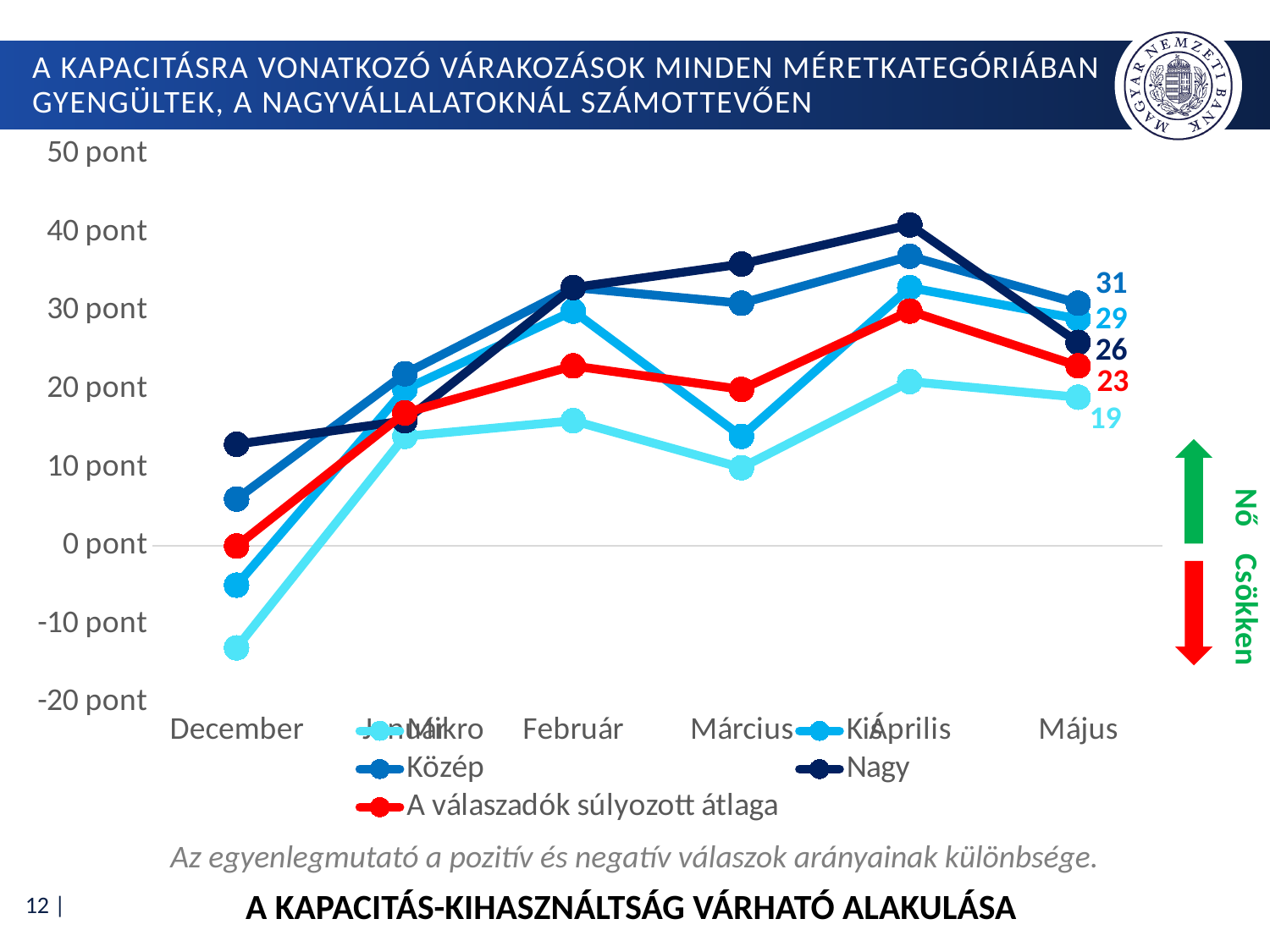
How many months are shown on the x axis? 6 Which series has the lowest value in Május? Mikro What is the difference between the Közép and Mikro values in Május? 12 Is the value for Mikro in December greater or less than -10 pont? less Is the value for Nagy in Március greater or less than 30 pont? greater In Május, which is larger: the value for Kis or the value for Nagy? Kis How many series does the legend list? 5 What is the value for Mikro in Május? 19 What is the value of A válaszadók súlyozott átlaga in Május? 23 What is the value for Közép in Május? 31 What kind of chart is shown on the slide? line chart What is the chart title shown at the bottom of the slide? A KAPACITÁS-KIHASZNÁLTSÁG VÁRHATÓ ALAKULÁSA